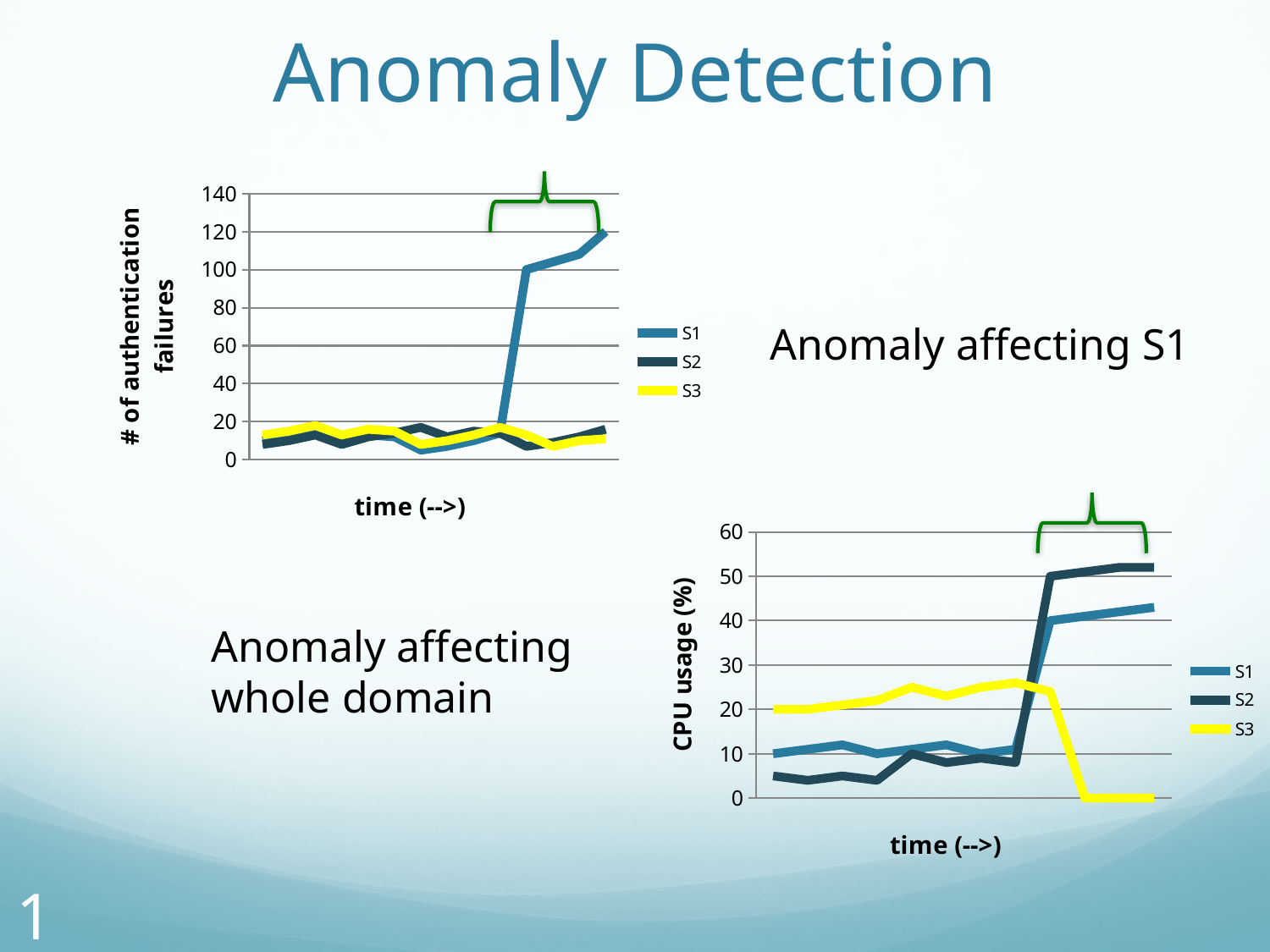
In the bottom-right chart, is the final value of S2 greater or less than 40? greater In the top-left chart, is the final value of S1 greater or less than 100? greater How many series does the legend of the bottom-right chart list? 3 In the top-left chart, is the final value of S3 greater or less than 20? less In the bottom-right chart, at the last time point, which series is higher, S1 or S2? S2 What type of chart is the bottom-right chart on the slide? line chart In the top-left chart, at the last time point, which series is higher, S1 or S2? S1 What type of chart is the top-left chart on the slide? line chart How many series does the legend of the top-left chart list? 3 In the bottom-right chart, does the S3 series rise or fall at the end of the time axis? fall What is the y-axis label of the bottom-right chart? CPU usage (%)